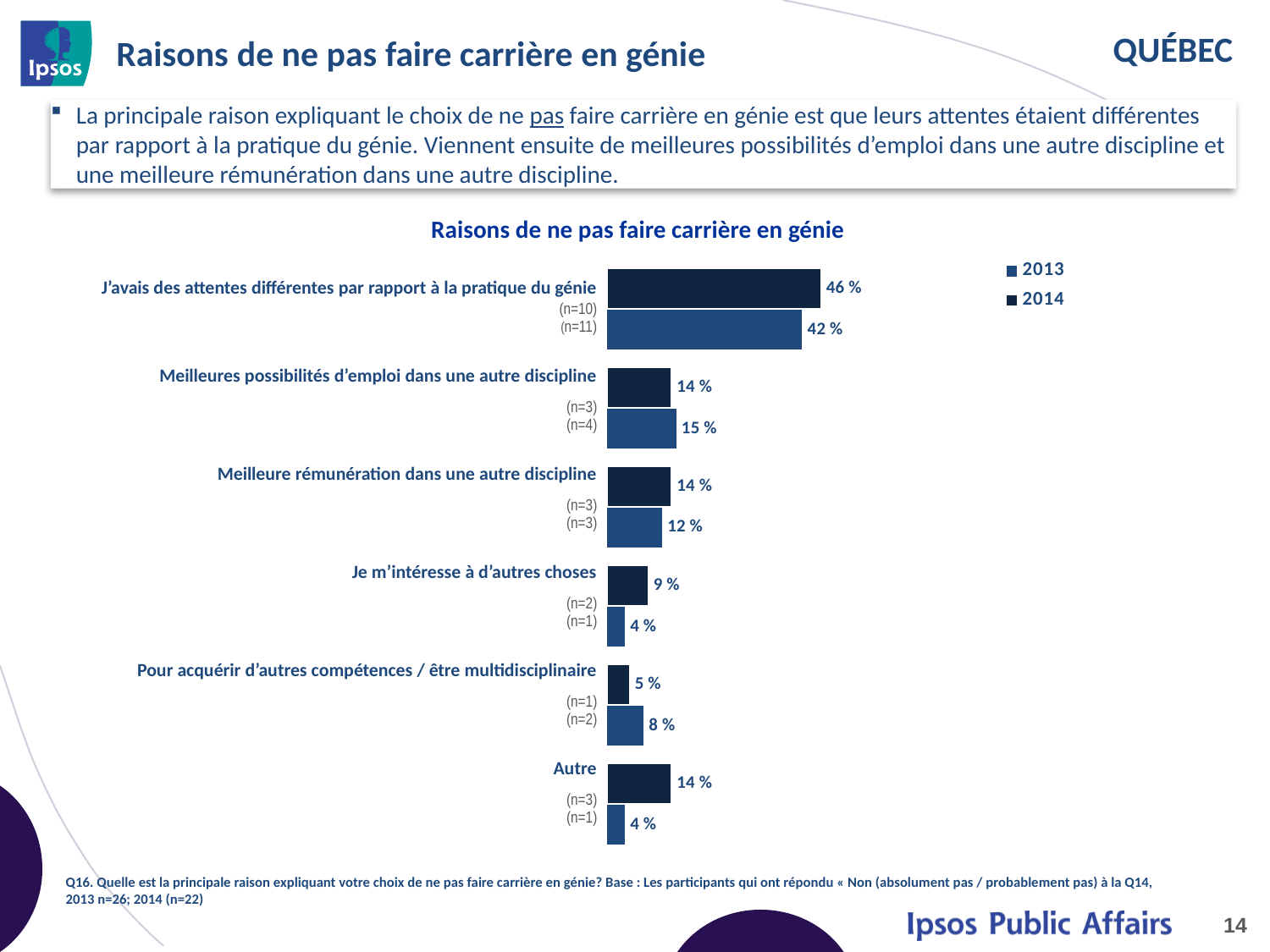
How many series does the legend list? 2 Which category has the highest 2014 value? J'avais des attentes différentes par rapport à la pratique du génie How many categories are shown in the chart? 6 What kind of chart is shown on the slide? Bar chart What is the 2014 value for "Autre"? 14 % What is the difference between the 2013 and 2014 values for "J'avais des attentes différentes par rapport à la pratique du génie"? 4 % Which is larger for "Autre": the 2013 value or the 2014 value? 2014 What is the 2013 value for "J'avais des attentes différentes par rapport à la pratique du génie"? 42 % What is the title of the chart? Raisons de ne pas faire carrière en génie Which is larger for "Pour acquérir d'autres compétences / être multidisciplinaire": the 2013 value or the 2014 value? 2013 What is the 2014 value for "Meilleures possibilités d'emploi dans une autre discipline"? 14 %